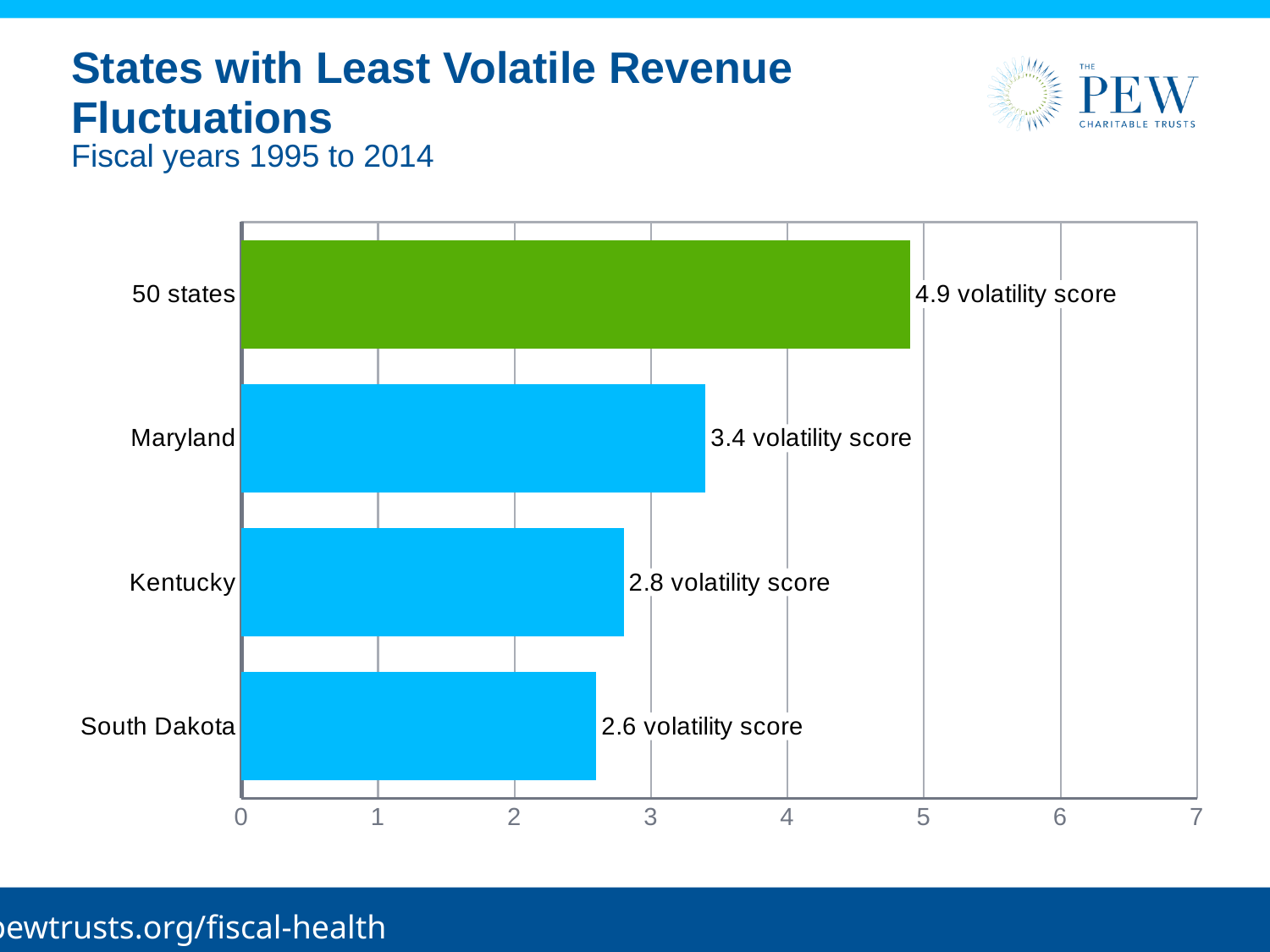
Which category has the lowest volatility score? South Dakota What kind of chart is shown on the slide? Bar chart Is the volatility score for Kentucky greater or less than 3? less What is the difference between the volatility scores of Kentucky and South Dakota? 0.2 Which category has the highest volatility score? 50 states What is the volatility score for Maryland? 3.4 What fiscal years does the chart subtitle say the data covers? Fiscal years 1995 to 2014 What is the volatility score for South Dakota? 2.6 What is the difference between the volatility scores of the 50 states and Maryland? 1.5 How many categories are shown in the chart? 4 Which has a higher volatility score, Maryland or Kentucky? Maryland What is the volatility score shown for the 50 states? 4.9